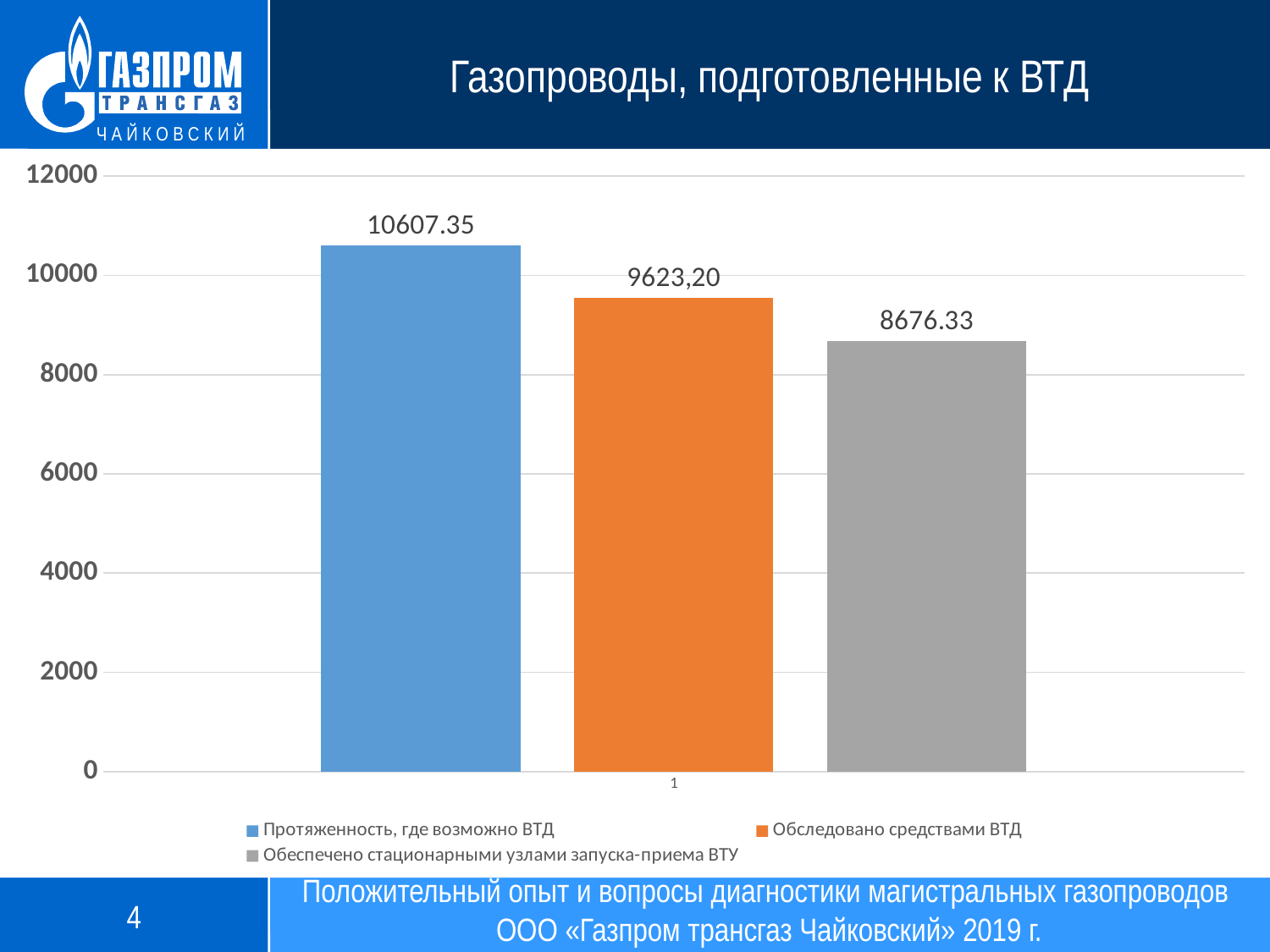
What is the value for the series "Обследовано средствами ВТД"? 9623,20 Is the value for "Обследовано средствами ВТД" greater or less than 10000? less Which is larger: the value for "Обследовано средствами ВТД" or the value for "Обеспечено стационарными узлами запуска-приема ВТУ"? Обследовано средствами ВТД Is the value for "Протяженность, где возможно ВТД" greater or less than 10000? greater What is the value for the series "Обеспечено стационарными узлами запуска-приема ВТУ"? 8676.33 How many series does the legend list? 3 What is the value for the series "Протяженность, где возможно ВТД"? 10607.35 Which series has the lowest value? Обеспечено стационарными узлами запуска-приема ВТУ What kind of chart is shown on the slide? bar chart What is the title of the chart? Газопроводы, подготовленные к ВТД What is the difference between the values for "Протяженность, где возможно ВТД" and "Обеспечено стационарными узлами запуска-приема ВТУ"? 1931.02 Which series has the highest value? Протяженность, где возможно ВТД